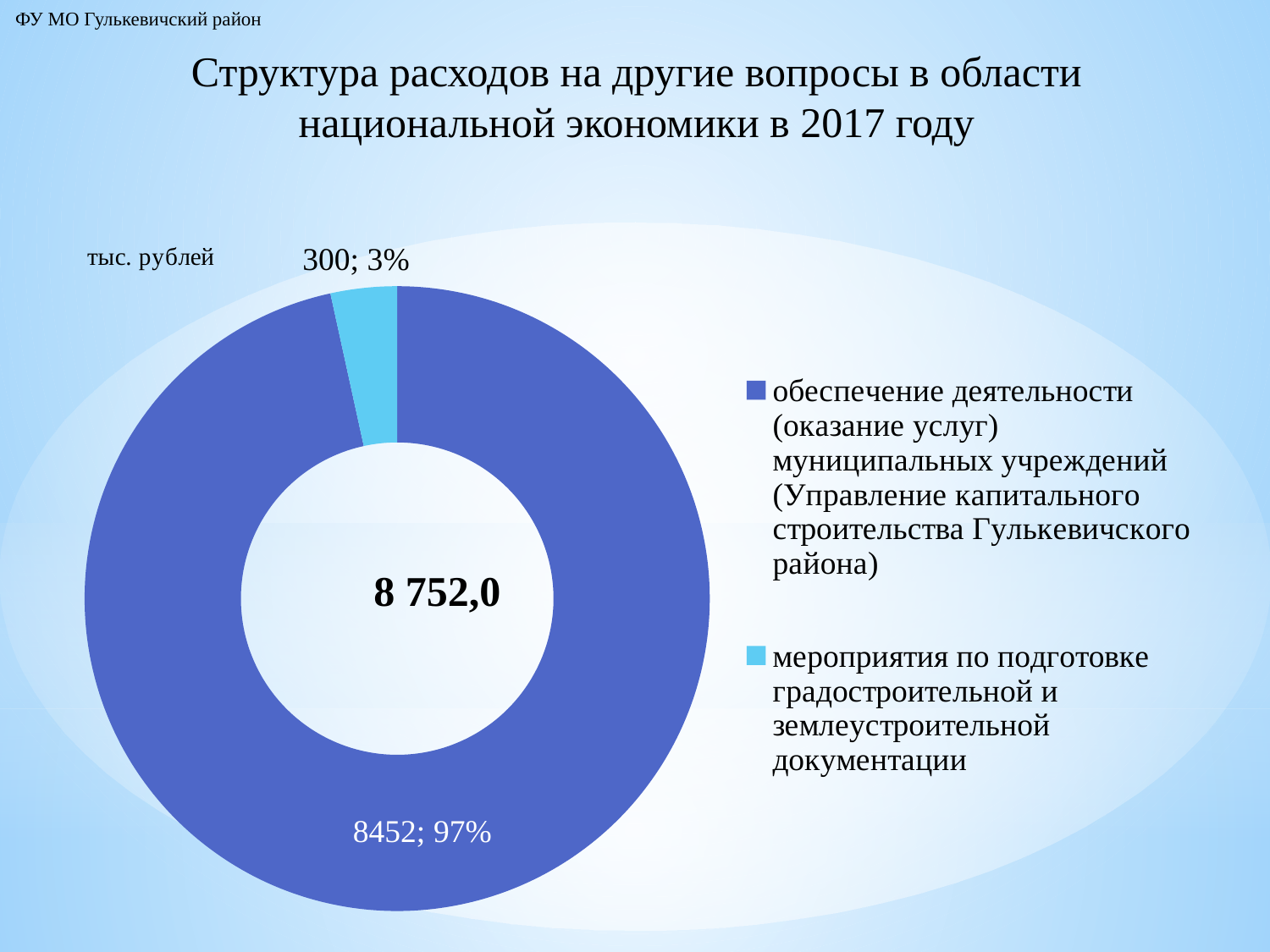
What is the value for «мероприятия по подготовке градостроительной и землеустроительной документации»? 300 How many categories does the chart show? 2 Which category has the smallest slice? мероприятия по подготовке градостроительной и землеустроительной документации What is the difference between the value for «обеспечение деятельности» and the value for «мероприятия по подготовке градостроительной и землеустроительной документации»? 8152 What total value is shown in the centre of the chart? 8 752,0 What is the value for «обеспечение деятельности (оказание услуг) муниципальных учреждений (Управление капитального строительства Гулькевичского района)»? 8452 What kind of chart is shown on the slide? Doughnut (pie) chart What share of the chart does «обеспечение деятельности (оказание услуг) муниципальных учреждений» represent? 97% Which category has the largest slice? обеспечение деятельности (оказание услуг) муниципальных учреждений (Управление капитального строительства Гулькевичского района) In what units are the chart values given? тыс. рублей What colour is the slice for «мероприятия по подготовке градостроительной и землеустроительной документации»? Light blue What share of the chart does «мероприятия по подготовке градостроительной и землеустроительной документации» represent? 3%